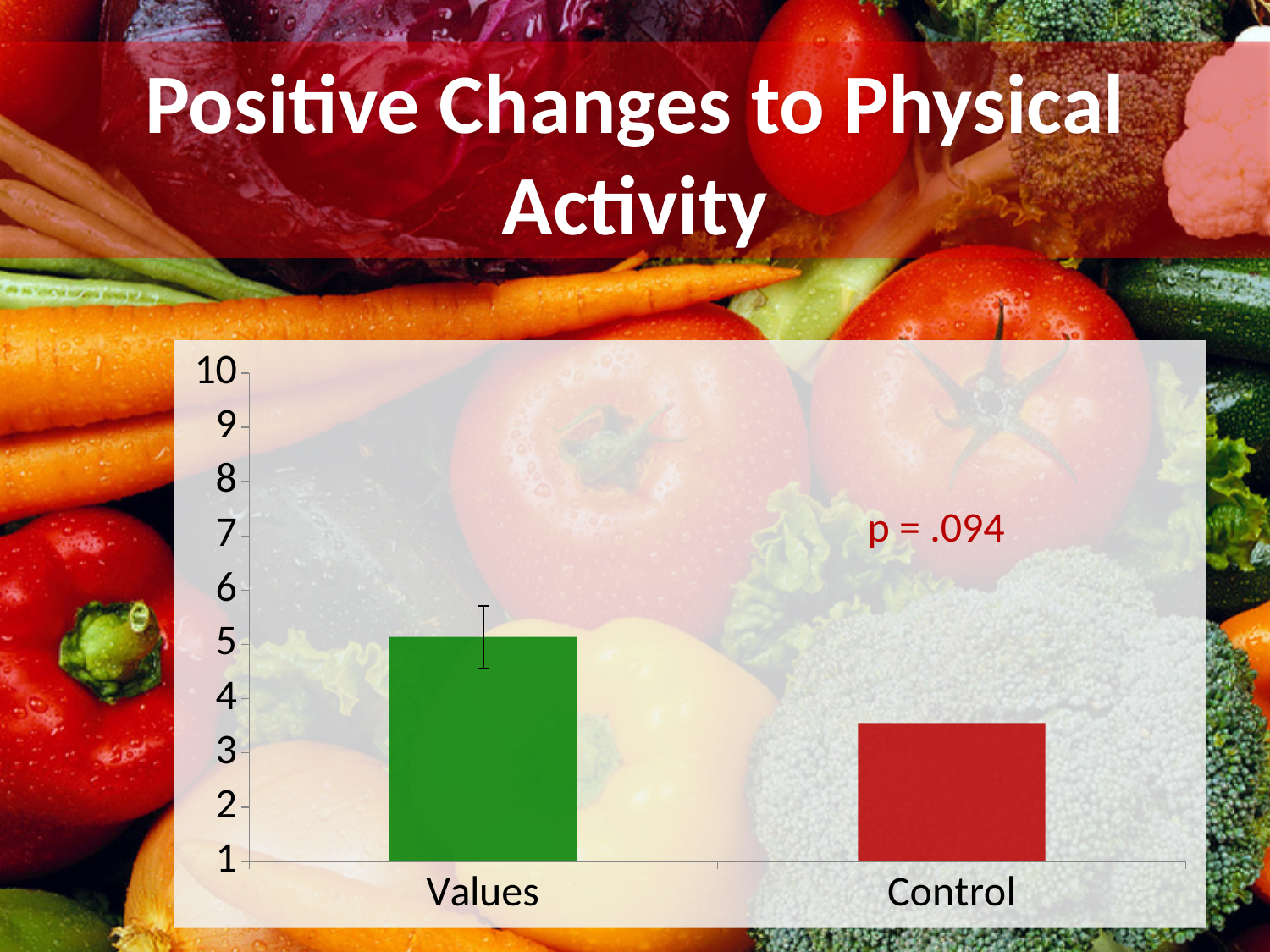
What colour is the bar for Values? green Which category has the lowest bar? Control Which is larger, the value for Values or the value for Control? Values Is the value for Values greater or less than 6? less What kind of chart is shown on the slide? bar chart Is the value for Values greater or less than 4? greater Do the bar values rise or fall from Values to Control? fall How many categories are plotted on the x axis? 2 Is the value for Control greater or less than 3? greater Which category has the highest bar? Values What p value is printed on the chart? p = .094